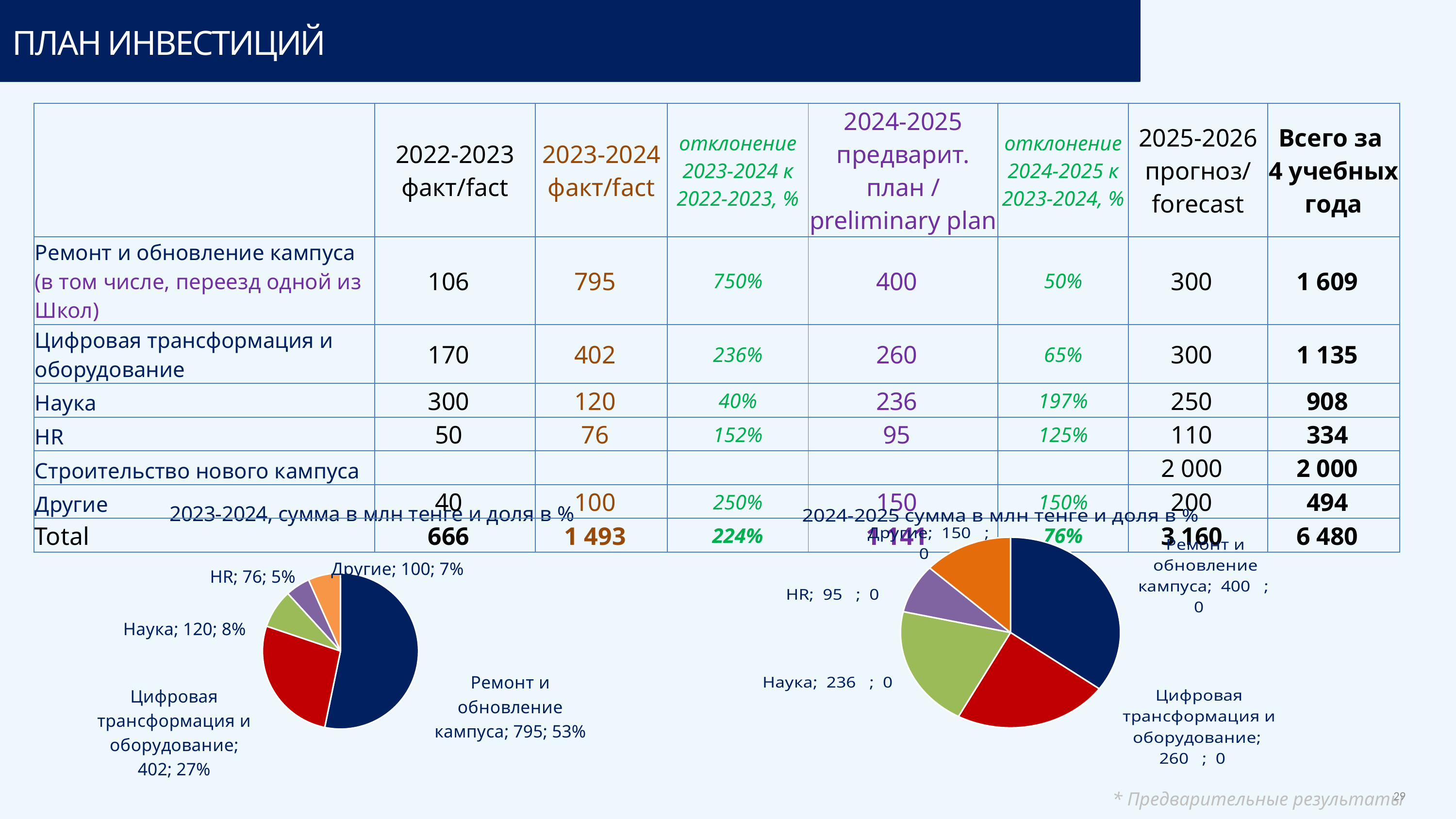
In the right pie chart (2024-2025), what is the value for Другие? 150 In the left pie chart (2023-2024), what is the difference between the values for Наука and Другие? 20 What type of chart is used for the 2023-2024 data at the bottom left of the slide? Pie chart In the right pie chart (2024-2025), which is larger: Цифровая трансформация и оборудование or HR? Цифровая трансформация и оборудование In the left pie chart (2023-2024), what is the value for HR? 76 How many slices does the right pie chart (2024-2025) have? 5 In the right pie chart (2024-2025), what is the value for Наука? 236 In the left pie chart (2023-2024), what is the value for Ремонт и обновление кампуса? 795 In the left pie chart (2023-2024), what share does Цифровая трансформация и оборудование have? 27% In the left pie chart (2023-2024), which category has the largest slice? Ремонт и обновление кампуса In the left pie chart (2023-2024), which category has the smallest slice? HR In the right pie chart (2024-2025), which category has the largest slice? Ремонт и обновление кампуса